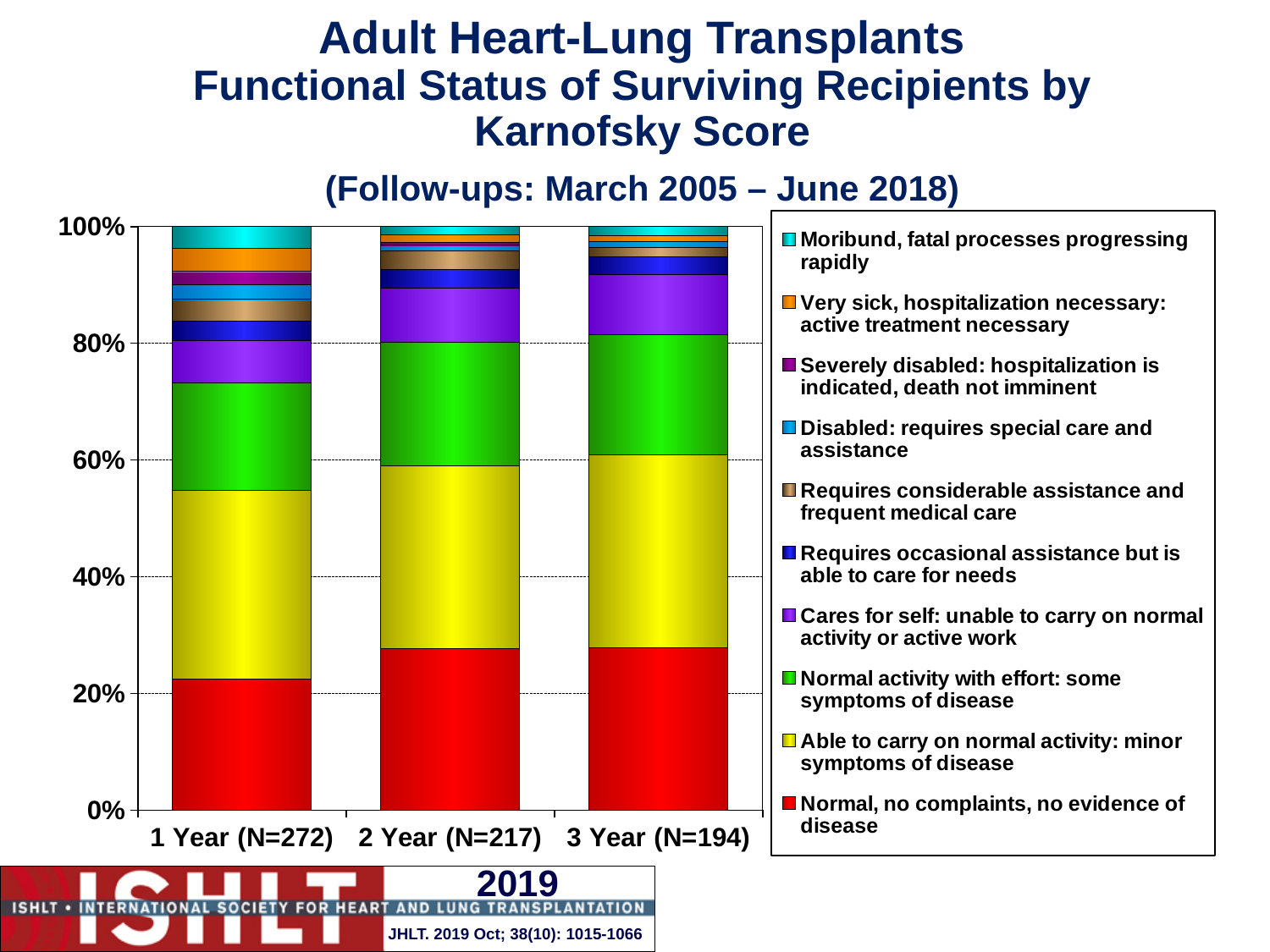
How many series does the legend list? 10 What is the total of each stacked bar? 100% Is the value for 'Normal, no complaints, no evidence of disease' at 1 Year (N=272) greater or less than 20%? greater Is the cumulative top of the 'Normal activity with effort: some symptoms of disease' segment at 1 Year (N=272) greater or less than 80%? less What colour represents 'Normal, no complaints, no evidence of disease' in the legend? Red Which has the larger 'Normal, no complaints, no evidence of disease' segment: 1 Year (N=272) or 3 Year (N=194)? 3 Year (N=194) Does the 'Normal, no complaints, no evidence of disease' segment rise or fall from 1 Year to 3 Year? rise What is the N for the 2 Year category? 217 Is the value for 'Normal, no complaints, no evidence of disease' at 3 Year (N=194) greater or less than 20%? greater How many categories (follow-up time points) are shown on the x axis? 3 What kind of chart is shown on the slide? Stacked bar chart